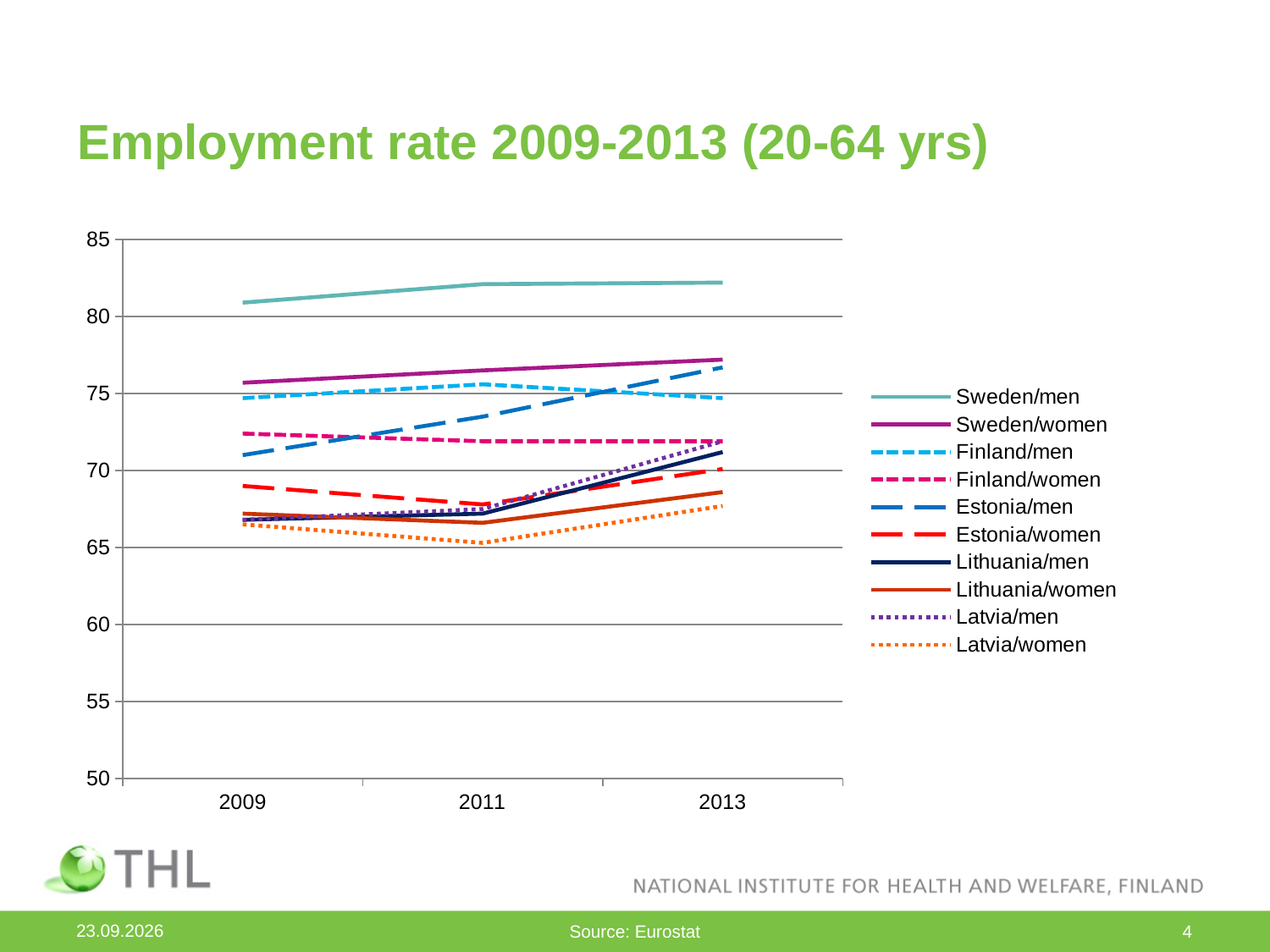
Is the value for Sweden/men in 2013 greater or less than 80? greater How many series does the legend list? 10 What kind of chart is shown on the slide? Line chart How many years are shown on the x axis? 3 Does the Estonia/men line rise or fall from 2009 to 2013? Rise Which series has the highest employment rate in 2013? Sweden/men Is the value for Estonia/men in 2013 greater or less than 75? greater Which series has the lowest employment rate in 2011? Latvia/women Which is larger in 2009, Finland/women or Estonia/women? Finland/women What is the title of the chart? Employment rate 2009-2013 (20-64 yrs) Which is larger in 2013, Estonia/men or Finland/men? Estonia/men Is the value for Latvia/women in 2011 greater or less than 70? less